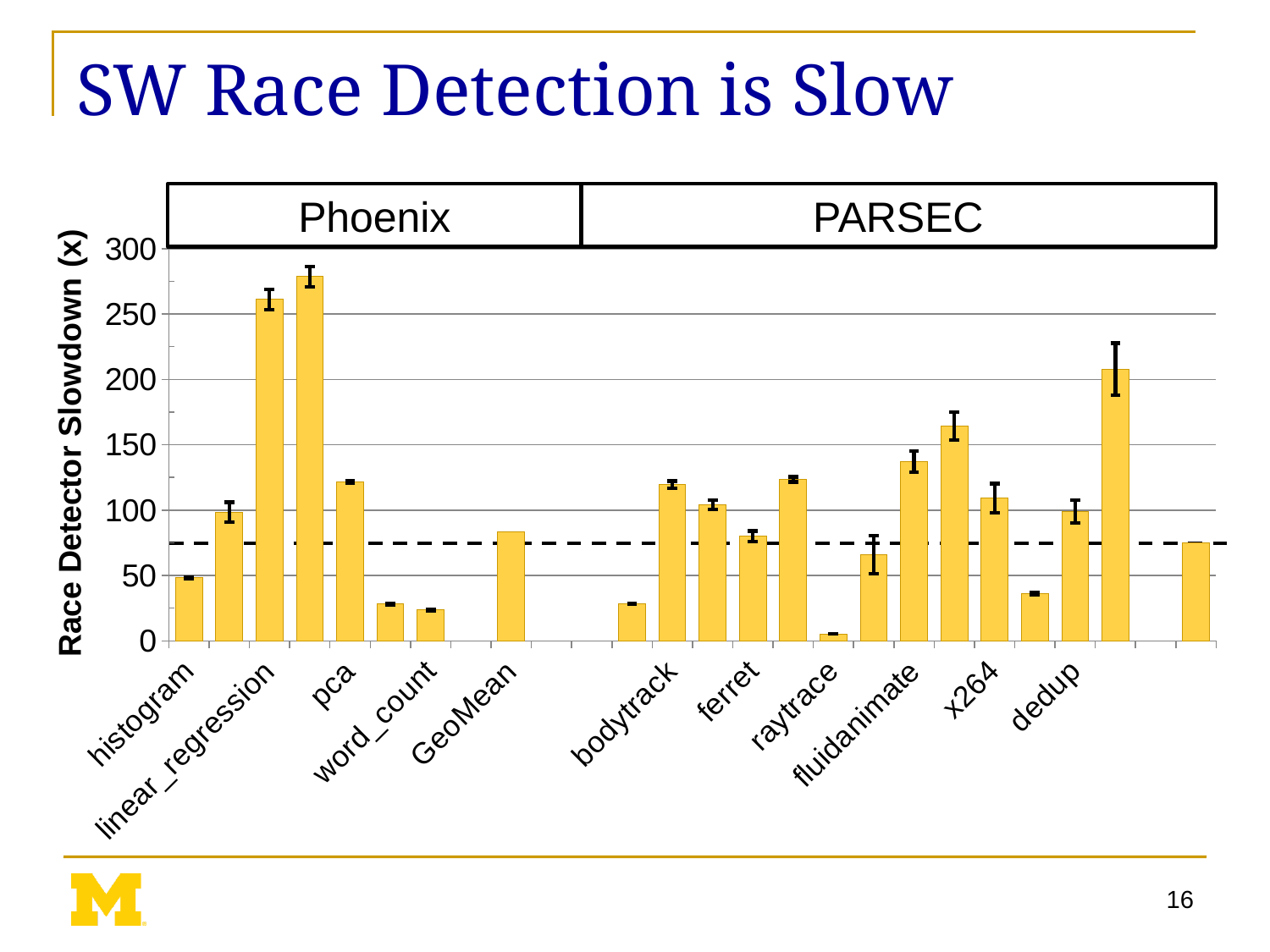
What is the label of the vertical axis? Race Detector Slowdown (x) Which group, Phoenix or PARSEC, contains the tallest bar in the chart? Phoenix Is the value for word_count greater or less than 50? less Which has the larger slowdown, histogram or pca? pca What type of chart is shown on the slide? bar chart Which has the larger slowdown, word_count or pca? pca Is the value for histogram greater or less than 100? less Is the value for fluidanimate greater or less than 150? less What are the two benchmark suite groups labelled above the chart? Phoenix and PARSEC